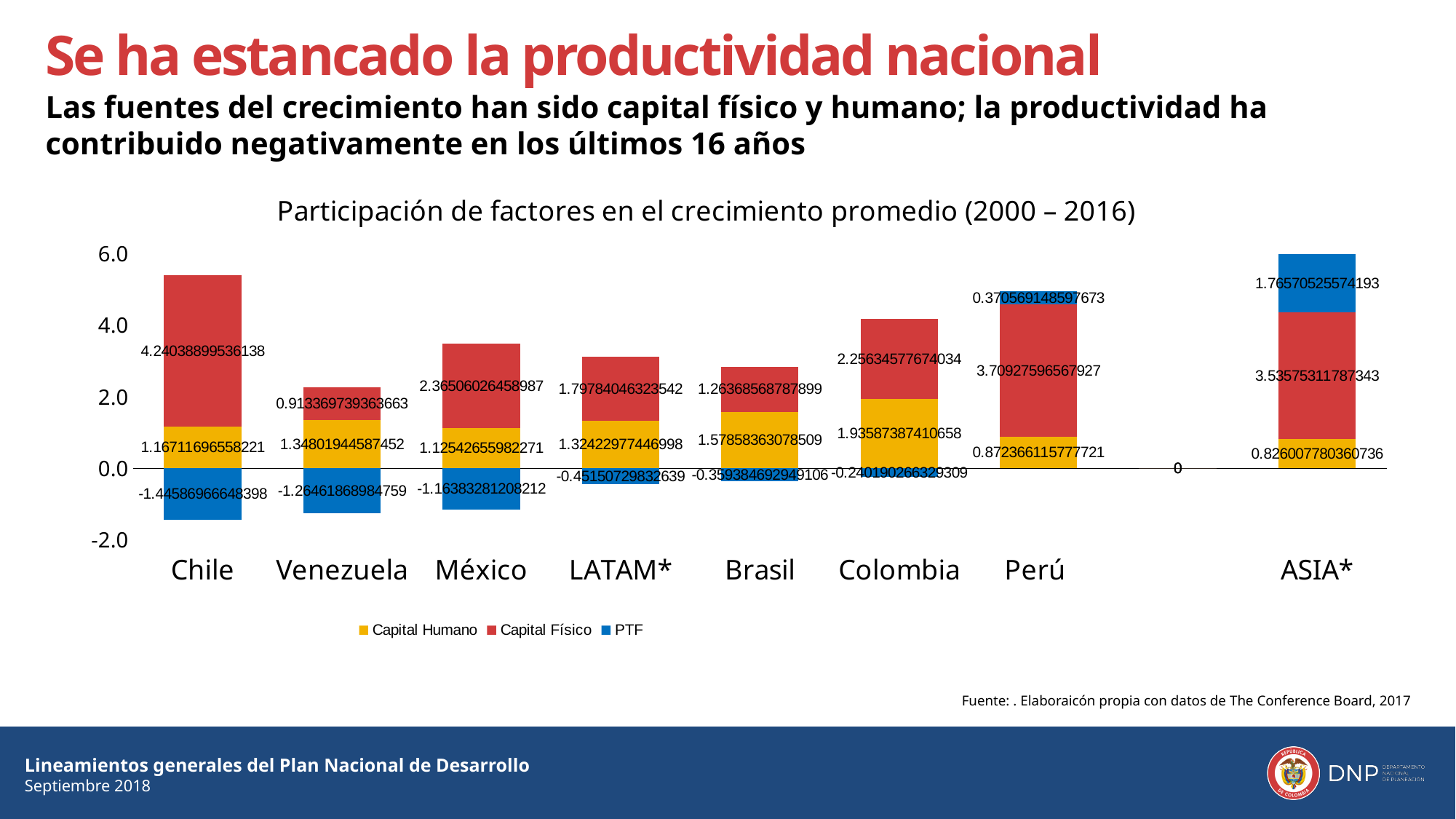
How many countries or regions are labelled on the x axis? 8 What is the PTF value for ASIA*? 1.76570525574193 Which category has the lowest PTF value? Chile What is the PTF value for Perú? 0.370569148597673 Which is larger, the Capital Físico value for Perú or for ASIA*? Perú What kind of chart is shown on the slide? Stacked bar chart Which category has the highest Capital Físico value? Chile What is the Capital Humano value for Colombia? 1.93587387410658 Is the PTF value for Colombia greater or less than 0.0? less How many series does the legend list? 3 Which colour represents PTF in the legend? Blue What is the Capital Físico value for Chile? 4.24038899536138